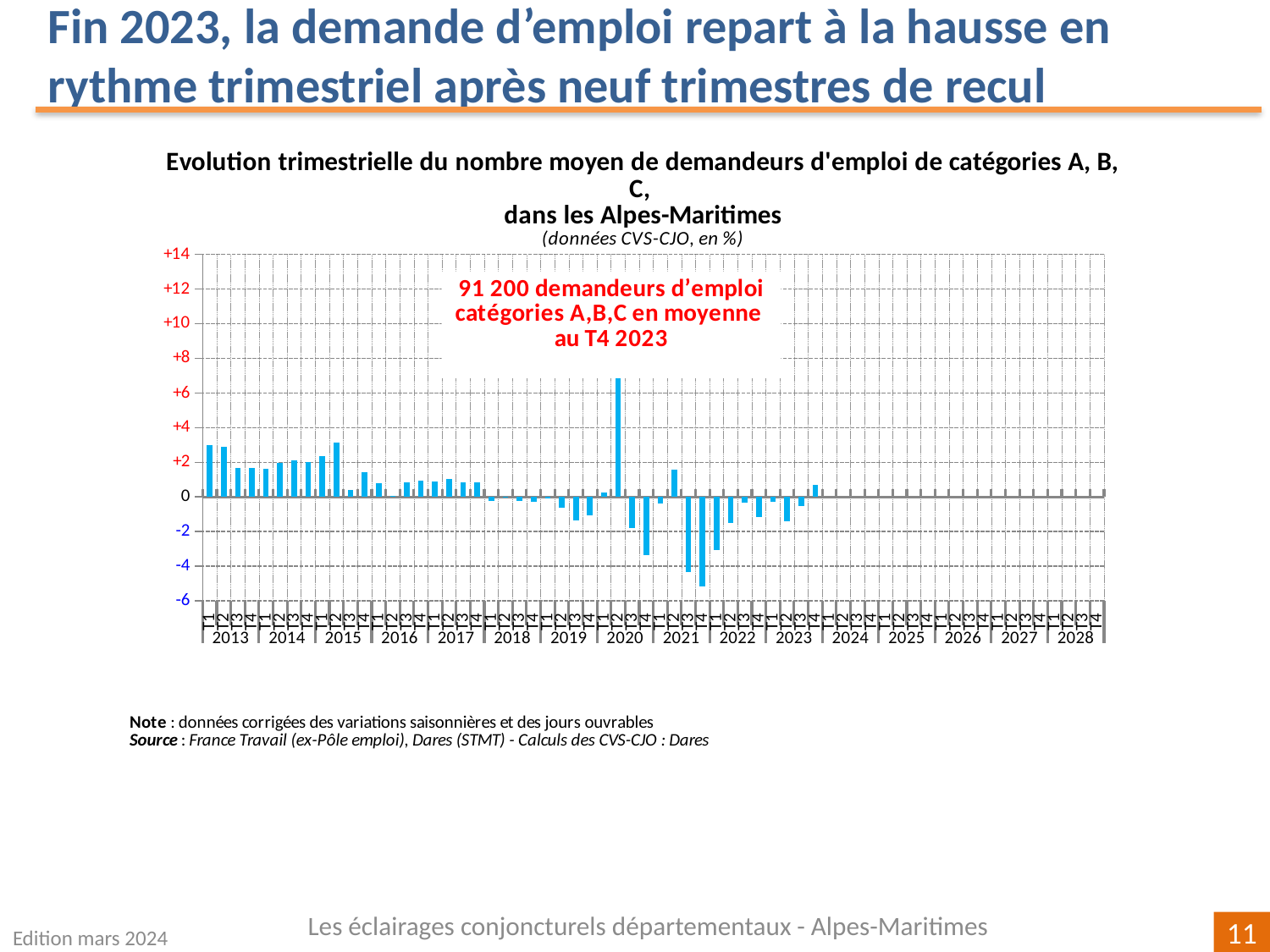
How many years are labelled along the horizontal axis of the chart? 16 What type of chart is shown on the slide? bar chart Is the value for T4 2020 greater or less than -2? less In which year does the chart show its lowest (most negative) bar? 2021 Which is larger, the value for T2 2020 or the value for T1 2013? T2 2020 Is the value for T4 2023 greater or less than 0? greater Is the value for T1 2013 greater or less than +2? greater What is the highest value shown on the vertical axis of the chart? +14 In which quarter does the chart show its highest bar? T2 2020 According to the annotation on the chart, how many demandeurs d'emploi catégories A, B, C were there on average in T4 2023? 91 200